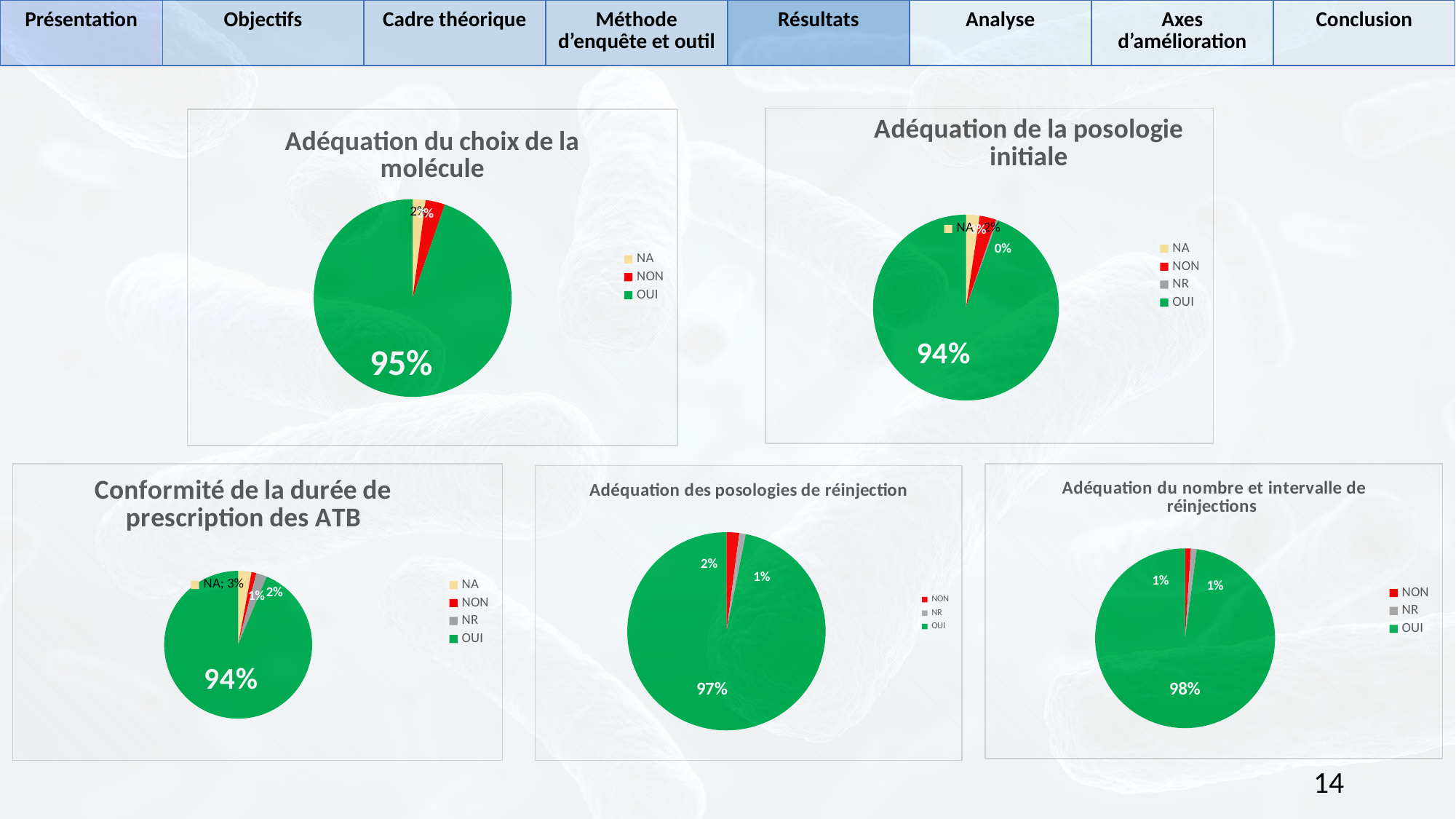
What type of chart is used for 'Adéquation du nombre et intervalle de réinjections'? Pie chart In the chart titled 'Conformité de la durée de prescription des ATB', what percentage is shown for NA? 3% In the chart titled 'Adéquation du choix de la molécule', which category has the largest slice? OUI In the chart titled 'Conformité de la durée de prescription des ATB', what percentage is shown for OUI? 94% In the chart titled 'Adéquation de la posologie initiale', what percentage is shown for OUI? 94% Which chart shows a larger OUI share: 'Adéquation des posologies de réinjection' or 'Adéquation du nombre et intervalle de réinjections'? Adéquation du nombre et intervalle de réinjections In the chart titled 'Adéquation des posologies de réinjection', what percentage is shown for OUI? 97% How many entries does the legend list in the chart titled 'Adéquation de la posologie initiale'? 4 In the chart titled 'Adéquation des posologies de réinjection', what percentage is shown for NON? 2% In the chart titled 'Adéquation du choix de la molécule', what percentage is shown for OUI? 95% In the chart titled 'Adéquation du nombre et intervalle de réinjections', what percentage is shown for OUI? 98% In the chart titled 'Adéquation des posologies de réinjection', what is the difference between the NON and NR percentages? 1%